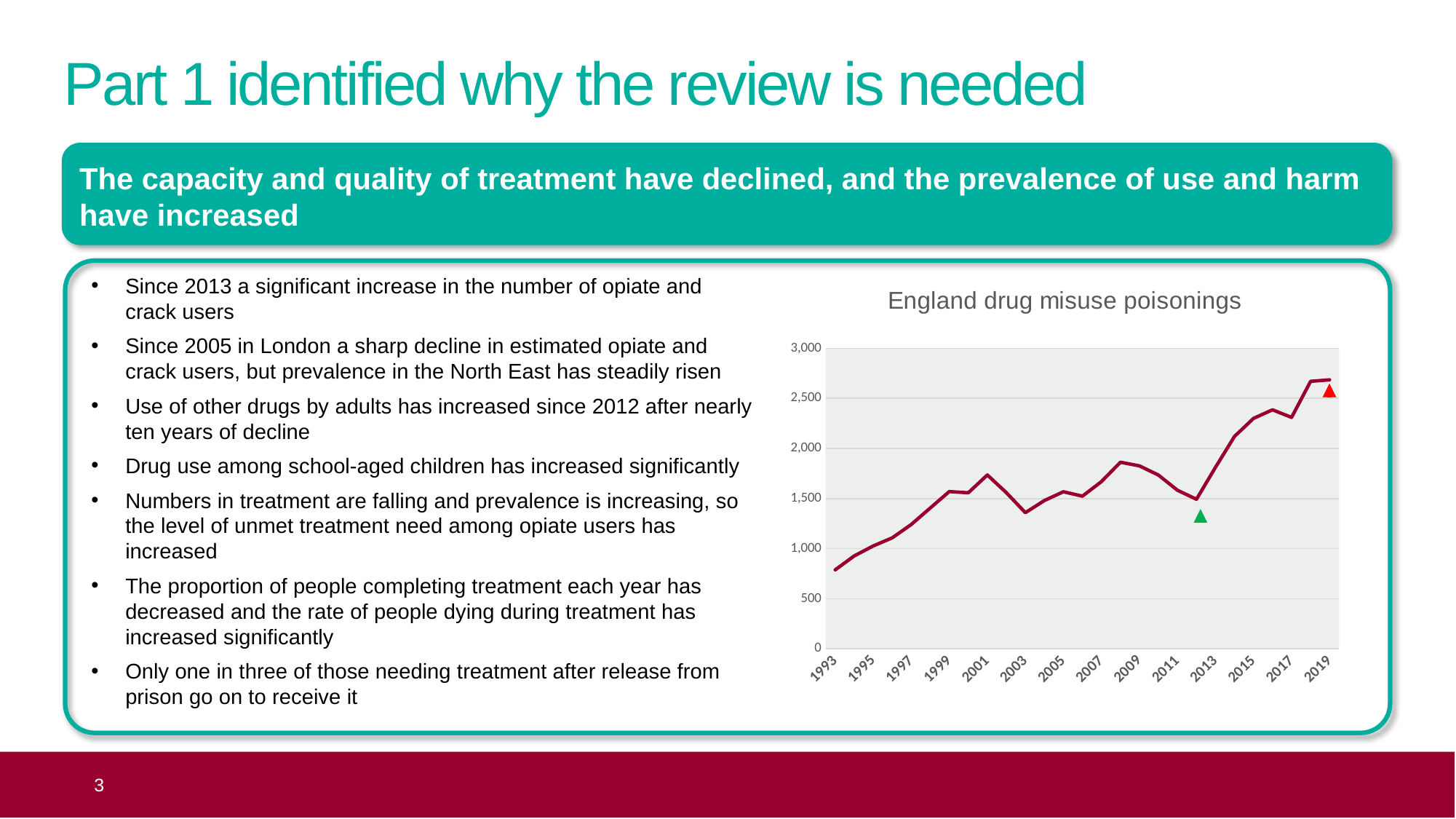
What is the highest value labelled on the y axis of the England drug misuse poisonings chart? 3,000 Is the value for 2003 in the England drug misuse poisonings chart greater or less than 1,500? less What kind of chart is shown on the slide? Line chart Which year has the lowest value in the England drug misuse poisonings chart? 1993 What is the title of the chart on the slide? England drug misuse poisonings Overall, do the values in the England drug misuse poisonings chart rise or fall from 1993 to 2019? Rise How many year labels are shown on the x axis of the England drug misuse poisonings chart? 14 Is the value for 2015 in the England drug misuse poisonings chart greater or less than 2,000? greater Is the value for 2019 in the England drug misuse poisonings chart greater or less than 2,500? greater In the England drug misuse poisonings chart, which year has the larger value, 2019 or 1993? 2019 In the England drug misuse poisonings chart, which year has the larger value, 2001 or 2003? 2001